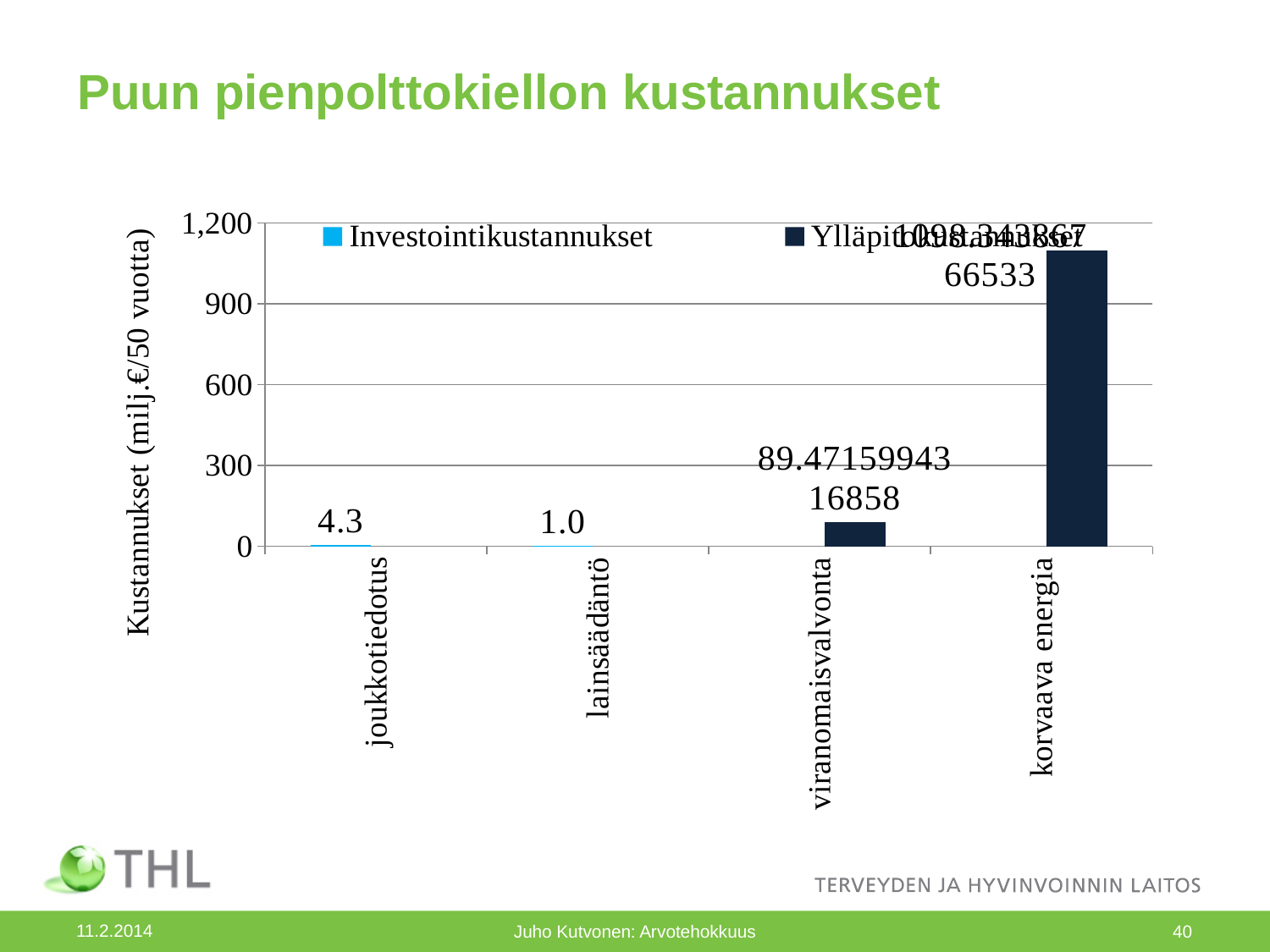
Is the value for viranomaisvalvonta greater or less than 300? less Is the value for korvaava energia greater or less than 900? greater Which is larger, the value for joukkotiedotus or the value for lainsäädäntö? joukkotiedotus What is the title of the y axis? Kustannukset (milj.€/50 vuotta) How many series does the legend list? 2 What is the difference between the values for joukkotiedotus and lainsäädäntö? 3.3 What is the value for joukkotiedotus? 4.3 Which category has the lowest cost? lainsäädäntö What type of chart is shown on the slide? bar chart What is the value for lainsäädäntö? 1.0 Which category has the highest cost? korvaava energia How many categories are shown on the x axis? 4